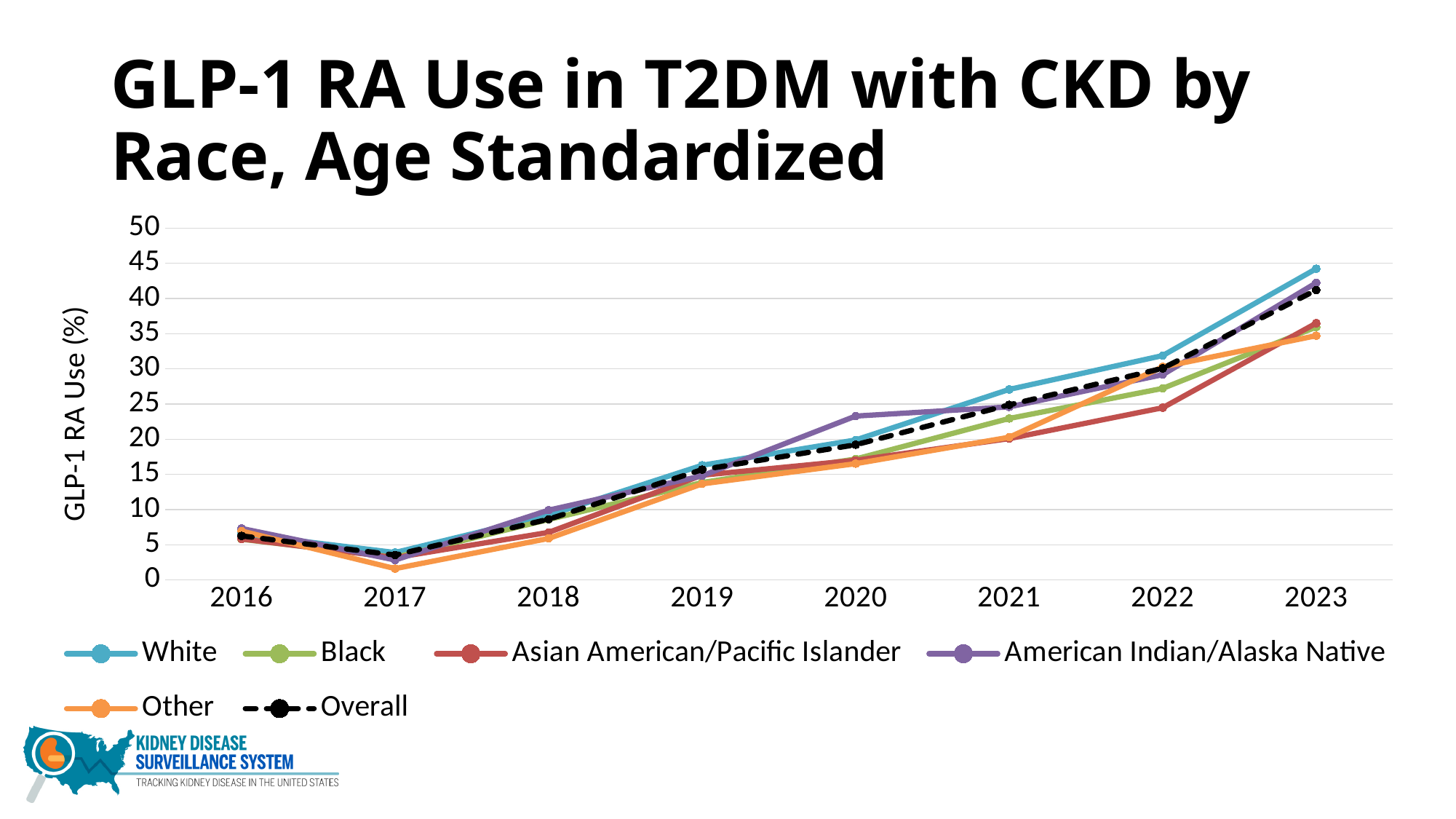
Which race group has the highest GLP-1 RA use in 2023? White How many years are shown on the x axis? 8 Which race group has the highest GLP-1 RA use in 2020? American Indian/Alaska Native Is the value for Asian American/Pacific Islander in 2021 greater or less than 25? less Does the Overall line rise or fall from 2017 to 2023? Rises Which series is drawn with a dashed line? Overall Which race group has the lowest GLP-1 RA use in 2017? Other Is the value for White in 2023 greater or less than 40? greater How many series does the legend list? 6 What kind of chart is shown on the slide? Line chart Is the value for American Indian/Alaska Native in 2020 greater or less than 20? greater In 2022, which is larger: the value for White or the value for Asian American/Pacific Islander? White